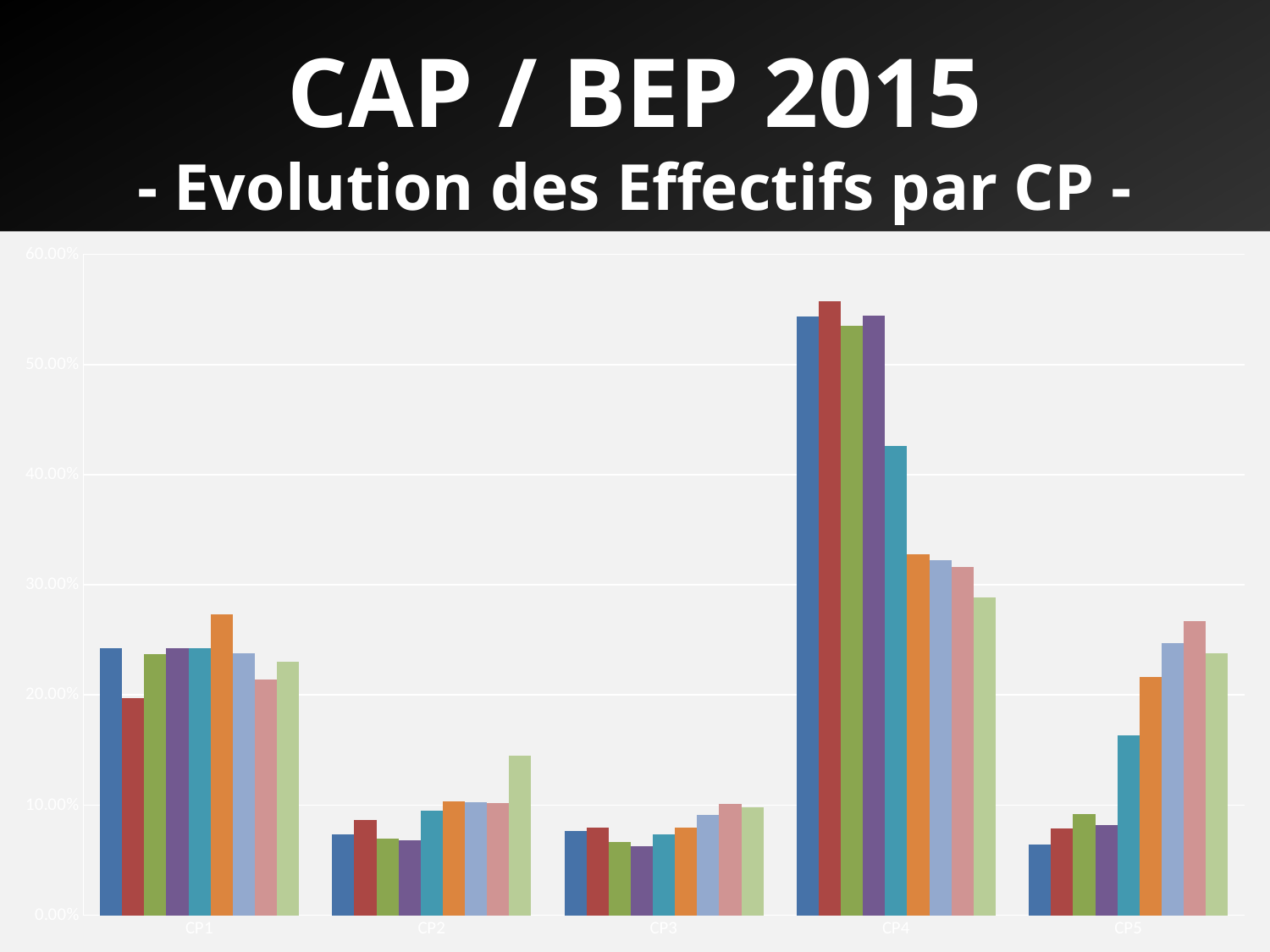
Is the value of the first (blue) bar for CP1 greater or less than 20%? greater What kind of chart is shown on the slide? bar chart Do the bars within the CP4 group generally rise or fall from left to right? fall Is the value of the first (blue) bar for CP4 greater or less than 50%? greater Which is larger: the first (blue) bar for CP4 or the first (blue) bar for CP2? CP4 Is the value of the first (blue) bar for CP3 greater or less than 10%? less How many categories are shown on the x axis of the chart? 5 Which category has the tallest bars in the chart? CP4 How many bars are plotted for the CP1 category? 9 What is the highest value shown on the vertical axis of the chart? 60.00%